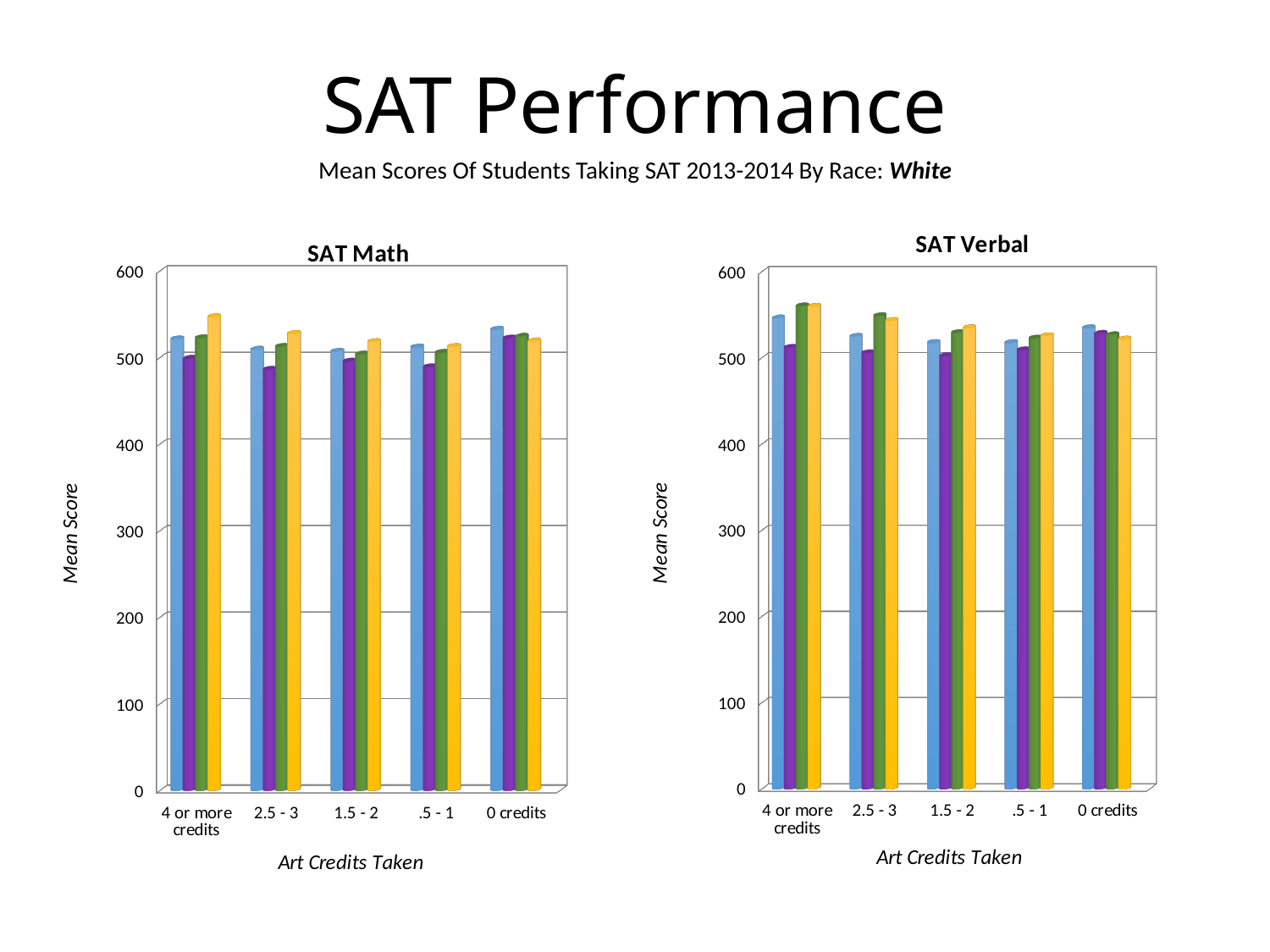
What kind of chart is the SAT Verbal chart? bar chart What kind of chart is the SAT Math chart? bar chart In the SAT Verbal chart, is the value of the shortest bar for '1.5 - 2' greater or less than 400? greater In the SAT Verbal chart, which category contains the tallest bar? 4 or more credits How many art-credit categories are shown on the x axis of the SAT Verbal chart? 5 In the SAT Math chart, is the value of the shortest bar for '2.5 - 3' greater or less than 500? less How many bars are plotted for each category in the SAT Verbal chart? 4 How many art-credit categories are shown on the x axis of the SAT Math chart? 5 What is the title of the y axis on the SAT Math chart? Mean Score What is the title of the x axis on the SAT Verbal chart? Art Credits Taken In the SAT Math chart, is the value of the tallest bar for '4 or more credits' greater or less than 500? greater